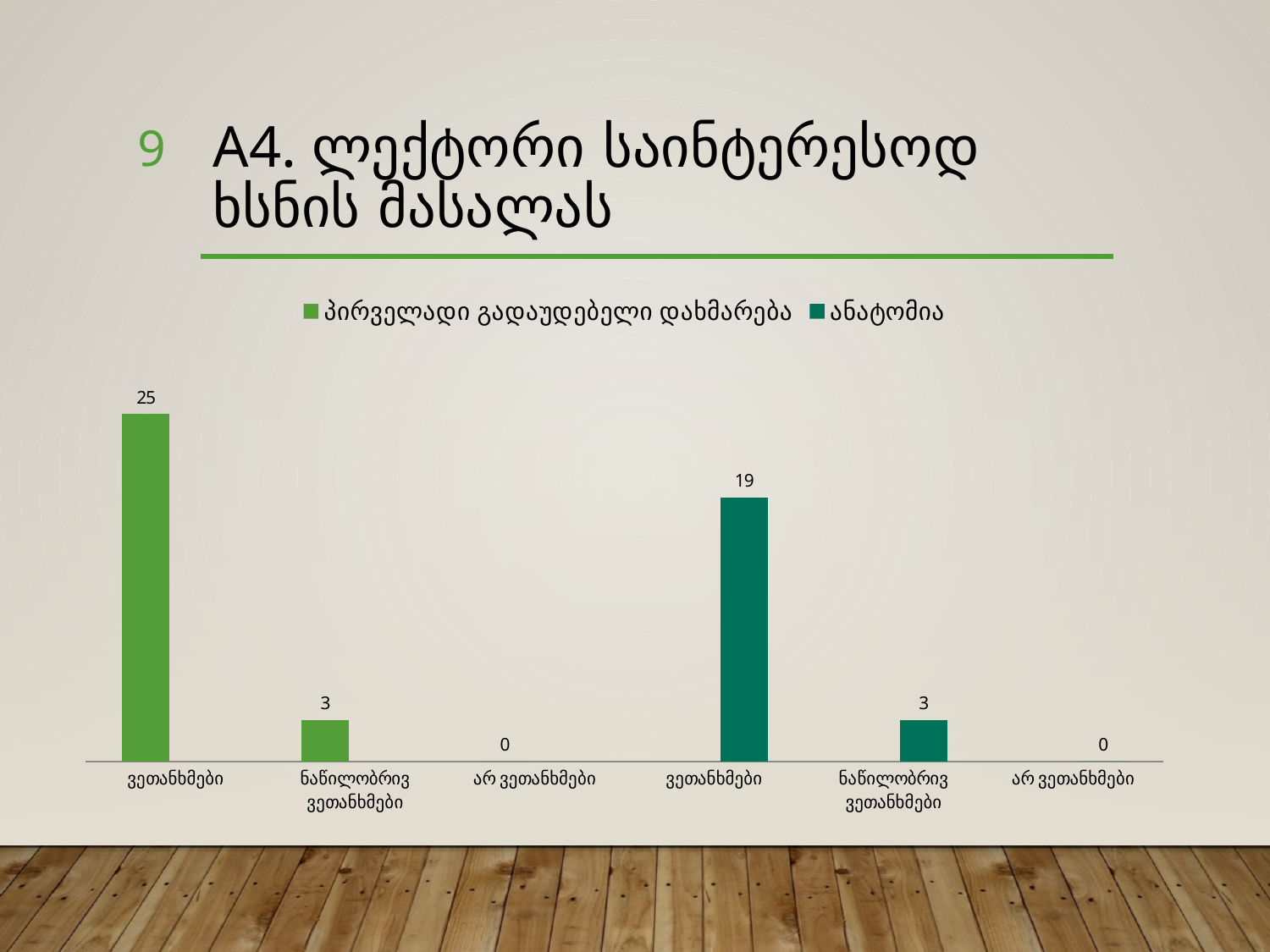
What is the value of the ნაწილობრივ ვეთანხმები bar for the ანატომია series? 3 What is the value of the ვეთანხმები bar for the პირველადი გადაუდებელი დახმარება series? 25 What is the difference between the ვეთანხმები values for პირველადი გადაუდებელი დახმარება and ანატომია? 6 What is the value of the არ ვეთანხმები bar for the პირველადი გადაუდებელი დახმარება series? 0 Which legend entry is shown in the darker green colour? ანატომია What is the value of the ვეთანხმები bar for the ანატომია series? 19 Which bar has the highest value on the chart? ვეთანხმები (პირველადი გადაუდებელი დახმარება) How many series does the legend list? 2 How many bars are plotted on the chart in total? 6 What is the difference between the ვეთანხმები and ნაწილობრივ ვეთანხმები values for the ანატომია series? 16 What type of chart is shown on the slide? bar chart Which is larger: the ვეთანხმები value for პირველადი გადაუდებელი დახმარება or for ანატომია? პირველადი გადაუდებელი დახმარება